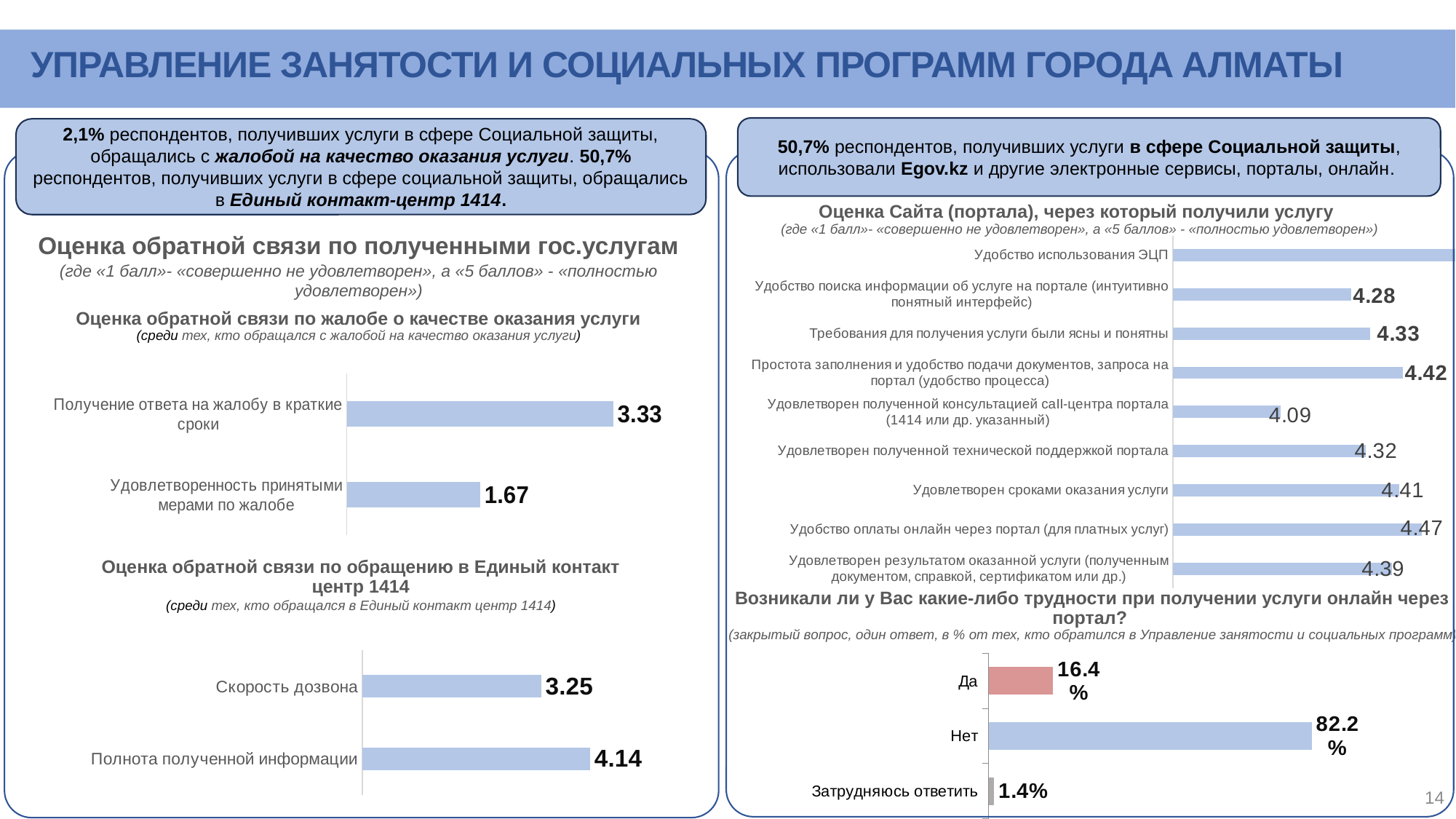
In the chart 'Оценка обратной связи по жалобе о качестве оказания услуги', what is the difference between the two values? 1.66 In the chart 'Возникали ли у Вас какие-либо трудности при получении услуги онлайн через портал?', what is the value for 'Нет'? 82.2% In the chart 'Возникали ли у Вас какие-либо трудности при получении услуги онлайн через портал?', what is the difference between 'Нет' and 'Да'? 65.8% What type of chart is 'Возникали ли у Вас какие-либо трудности при получении услуги онлайн через портал?'? Bar chart In the chart 'Оценка обратной связи по обращению в Единый контакт центр 1414', which category has the higher value? Полнота полученной информации In the chart 'Оценка Сайта (портала), через который получили услугу', which category has the lowest value? Удовлетворен полученной консультацией call-центра портала (1414 или др. указанный) How many categories are shown in the chart 'Оценка Сайта (портала), через который получили услугу'? 9 In the chart 'Оценка обратной связи по жалобе о качестве оказания услуги', what is the value for 'Получение ответа на жалобу в краткие сроки'? 3.33 In the chart 'Оценка обратной связи по жалобе о качестве оказания услуги', what is the value for 'Удовлетворенность принятыми мерами по жалобе'? 1.67 In the chart 'Оценка Сайта (портала), через который получили услугу', what is the value for 'Удобство оплаты онлайн через портал (для платных услуг)'? 4.47 In the chart 'Оценка обратной связи по обращению в Единый контакт центр 1414', what is the value for 'Скорость дозвона'? 3.25 In the chart 'Оценка Сайта (портала), через который получили услугу', what is the value for 'Удовлетворен полученной консультацией call-центра портала (1414 или др. указанный)'? 4.09